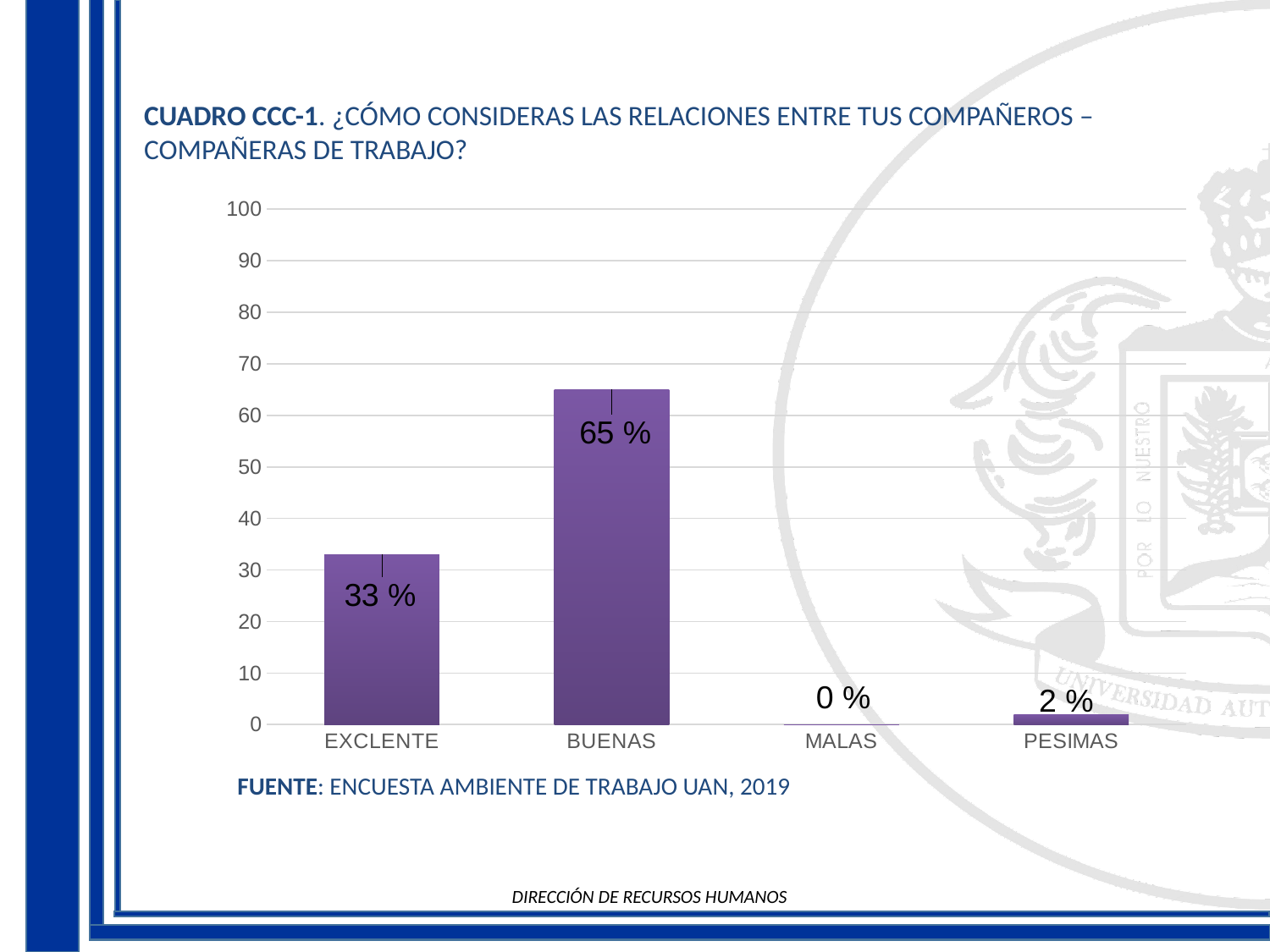
Is the value for BUENAS greater or less than 50? greater What is the difference between the values for BUENAS and EXCLENTE? 32 % Which category has the highest value? BUENAS What is the value for PESIMAS? 2 % What is the value for BUENAS? 65 % Which category has the lowest value? MALAS What is the value for EXCLENTE? 33 % What kind of chart is shown on the slide? bar chart What is the source cited below the chart? ENCUESTA AMBIENTE DE TRABAJO UAN, 2019 What is the value for MALAS? 0 % Which is larger, the value for EXCLENTE or the value for PESIMAS? EXCLENTE How many categories are shown on the x axis? 4